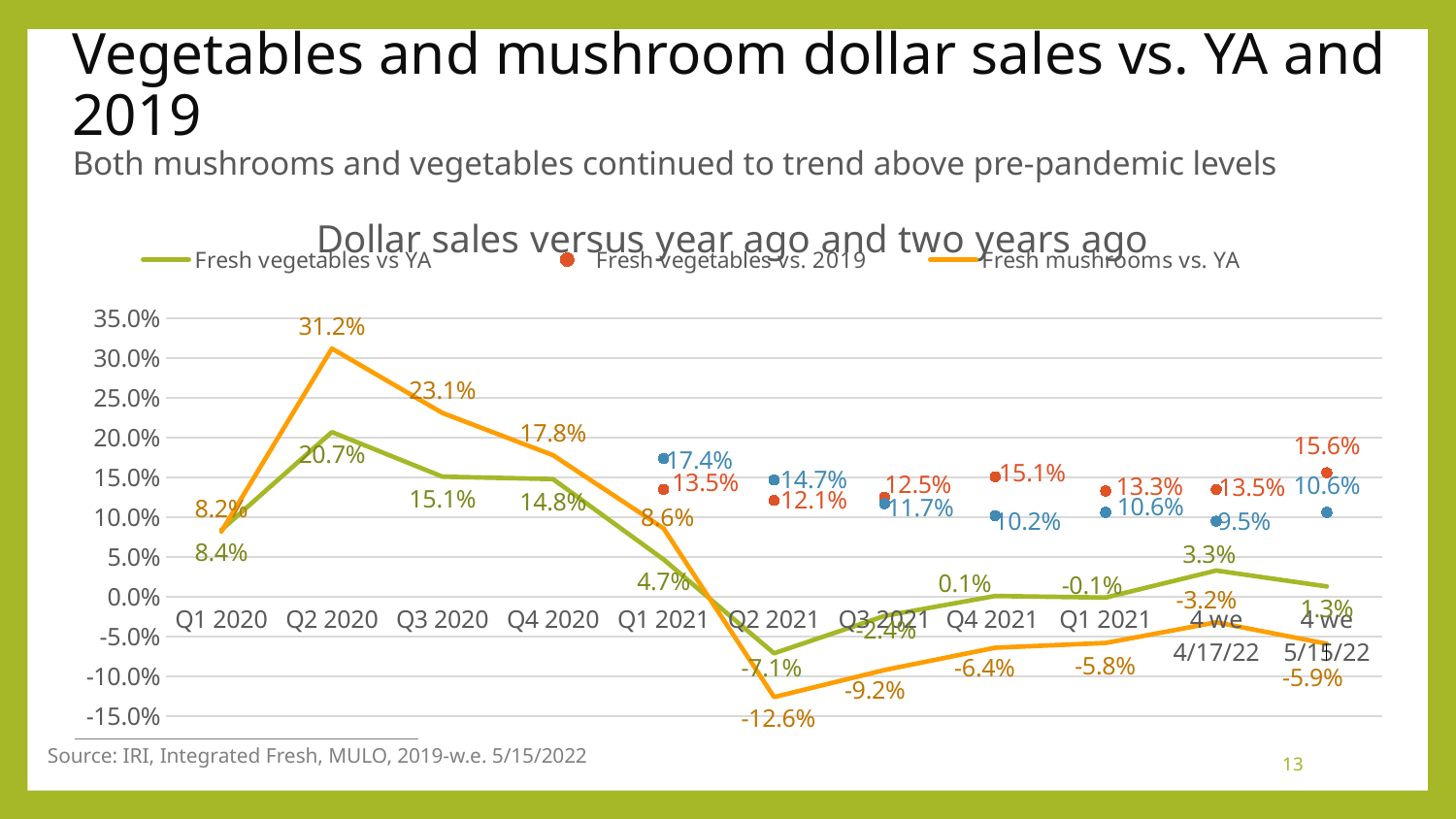
Does Fresh mushrooms vs. YA rise or fall from Q2 2020 to Q2 2021? Fall How many periods are shown on the x axis? 11 What is the value for Fresh vegetables vs. 2019 at 4 we 5/15/22? 15.6% What is the difference between Fresh mushrooms vs. YA and Fresh vegetables vs YA in Q2 2020? 10.5 percentage points How many series does the chart legend list? 3 In Q3 2020, which is larger: Fresh mushrooms vs. YA or Fresh vegetables vs YA? Fresh mushrooms vs. YA In which period is Fresh mushrooms vs. YA lowest? Q2 2021 In which period is Fresh vegetables vs YA highest? Q2 2020 What is the value for Fresh vegetables vs YA in Q2 2021? -7.1% What is the value for Fresh mushrooms vs. YA in Q2 2020? 31.2% In which period is Fresh mushrooms vs. YA highest? Q2 2020 What kind of chart is shown on the slide? Line chart